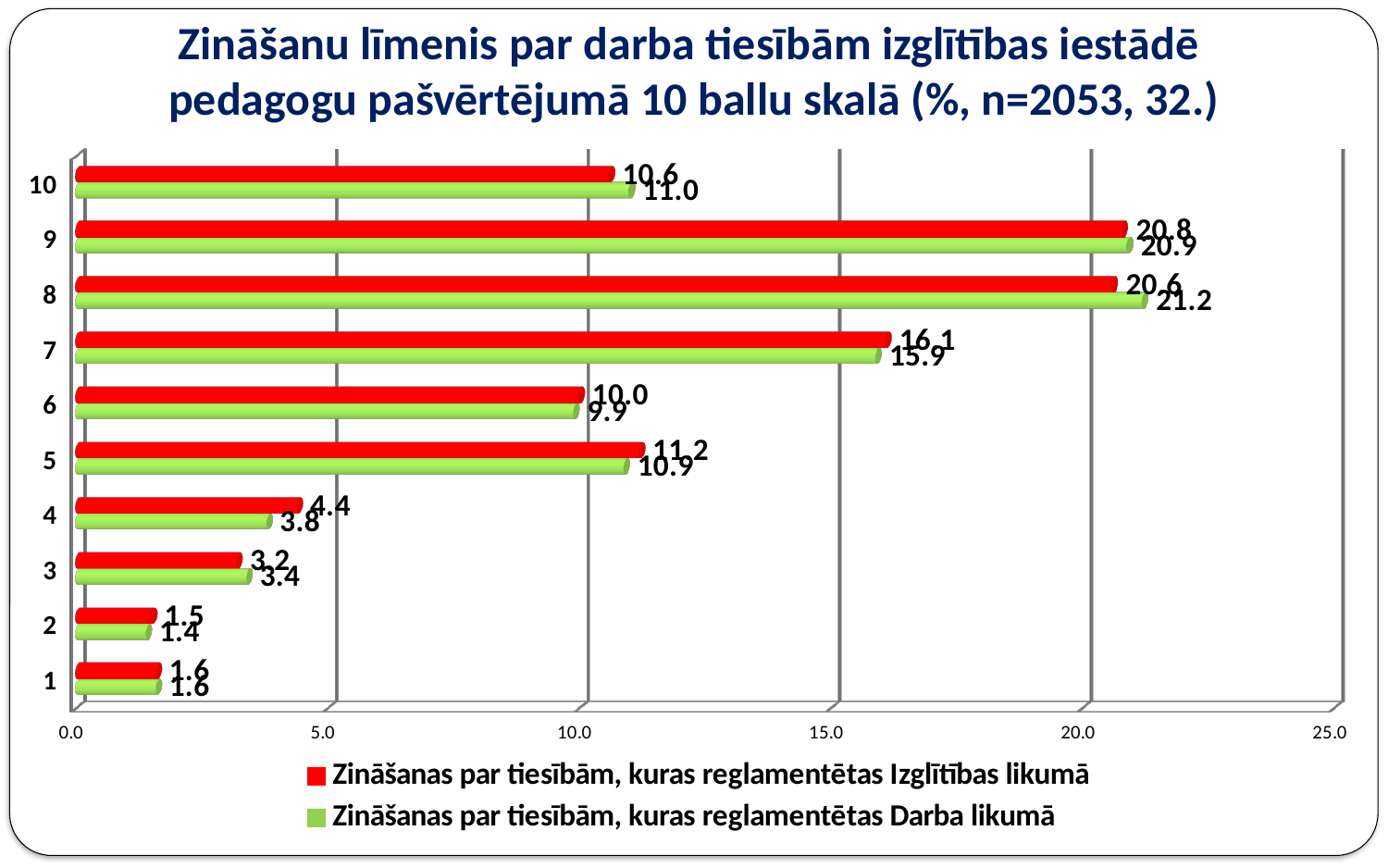
What kind of chart is shown on the slide? bar chart What is the value for category 4 in the series 'Zināšanas par tiesībām, kuras reglamentētas Izglītības likumā'? 4.4 How many categories are shown on the vertical axis? 10 What is the difference between the two series' values for category 4? 0.6 What is the value for category 8 in the series 'Zināšanas par tiesībām, kuras reglamentētas Darba likumā'? 21.2 How many series does the legend list? 2 Which category has the highest value in the series 'Zināšanas par tiesībām, kuras reglamentētas Darba likumā'? 8 Is the value for category 7 in the 'Darba likumā' series greater or less than 15.0? greater For category 5, which series has the larger value: 'Izglītības likumā' or 'Darba likumā'? Zināšanas par tiesībām, kuras reglamentētas Izglītības likumā What is the value for category 7 in the series 'Zināšanas par tiesībām, kuras reglamentētas Izglītības likumā'? 16.1 Which category has the lowest value in the series 'Zināšanas par tiesībām, kuras reglamentētas Darba likumā'? 2 What is the difference between the 'Izglītības likumā' values for category 9 and category 10? 10.2